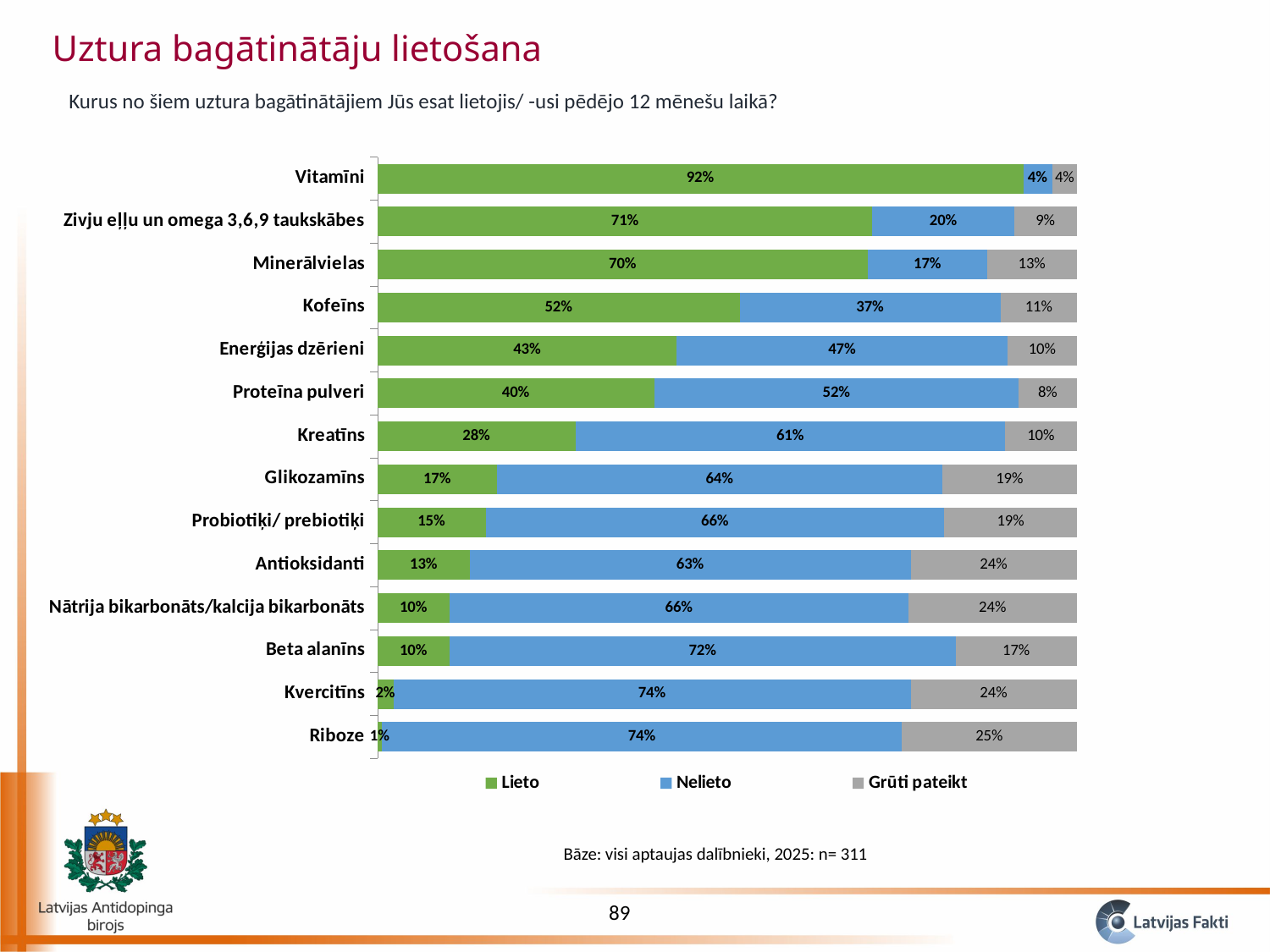
How many categories (supplements) are shown in the chart? 14 What is the Grūti pateikt value for Antioksidanti? 24% Which category has the highest Lieto share? Vitamīni Which is larger: the Nelieto value for Kreatīns or the Nelieto value for Proteīna pulveri? Kreatīns Which category has the lowest Lieto share? Riboze What is the Nelieto value for Kofeīns? 37% What is the difference between the Lieto values for Zivju eļļu un omega 3,6,9 taukskābes and Minerālvielas? 1% How many series does the legend list? 3 What kind of chart is shown on the slide? Stacked bar chart What percentage of respondents use (Lieto) Vitamīni? 92% What is the total of the three segments for Enerģijas dzērieni? 100% Which series is shown in green in the legend? Lieto